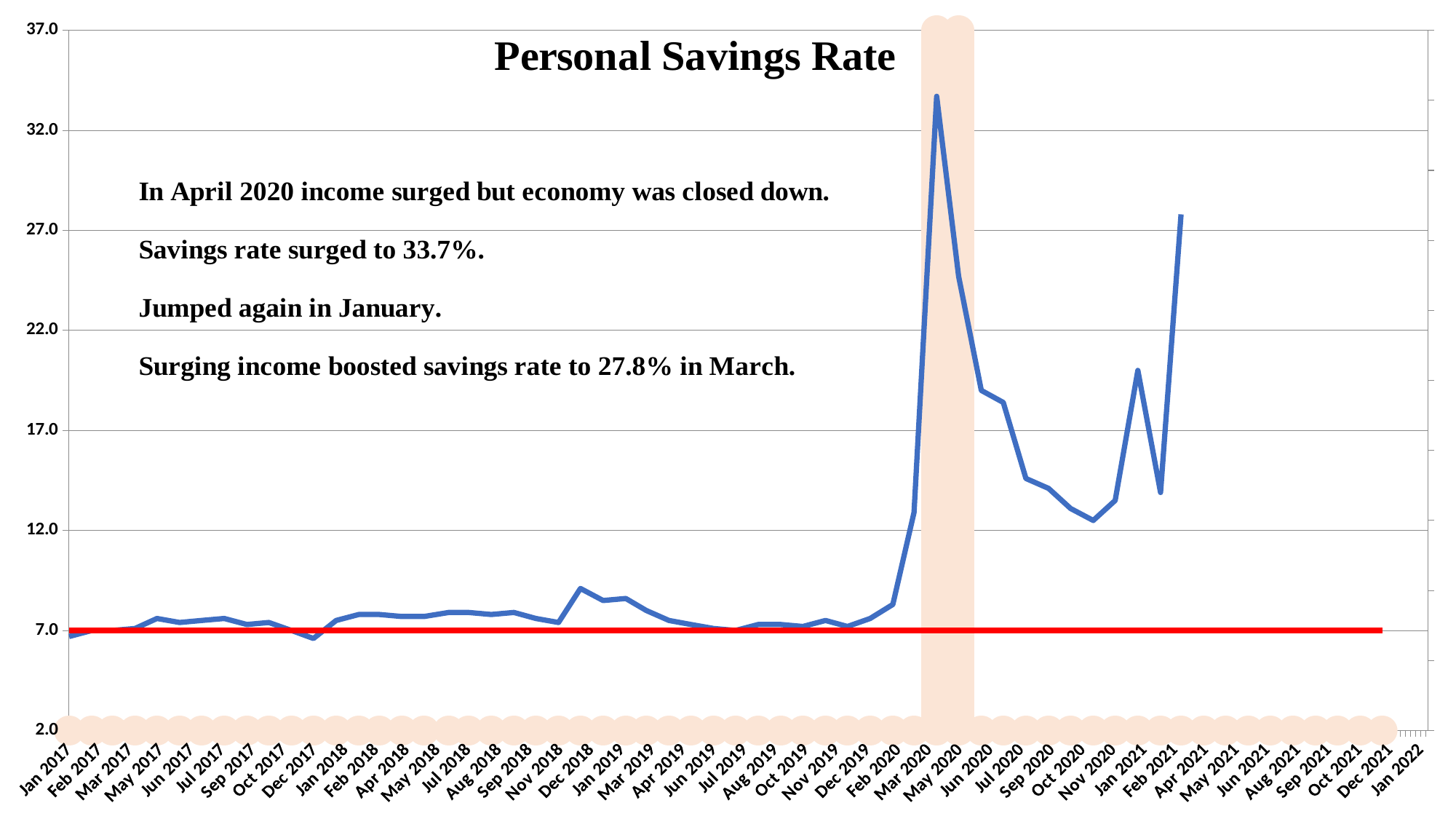
Does the savings rate rise or fall between Apr 2020 and Oct 2020? fall Is the value for Oct 2020 greater or less than 17.0? less What savings rate did the line reach at its April 2020 peak, according to the slide? 33.7% What savings rate is stated for March 2021 on the slide? 27.8% In which month does the personal savings rate reach its highest point? April 2020 At what value on the y axis is the red horizontal line drawn? 7.0 What is the title of the chart? Personal Savings Rate Which is larger, the value for Jan 2021 or the value for Feb 2021? Jan 2021 Which is larger, the value for Apr 2020 or the value for Mar 2021? Apr 2020 What type of chart is shown on the slide? line chart Is the value for Jan 2021 greater or less than 17.0? greater Is the value for Dec 2018 greater or less than 7.0? greater